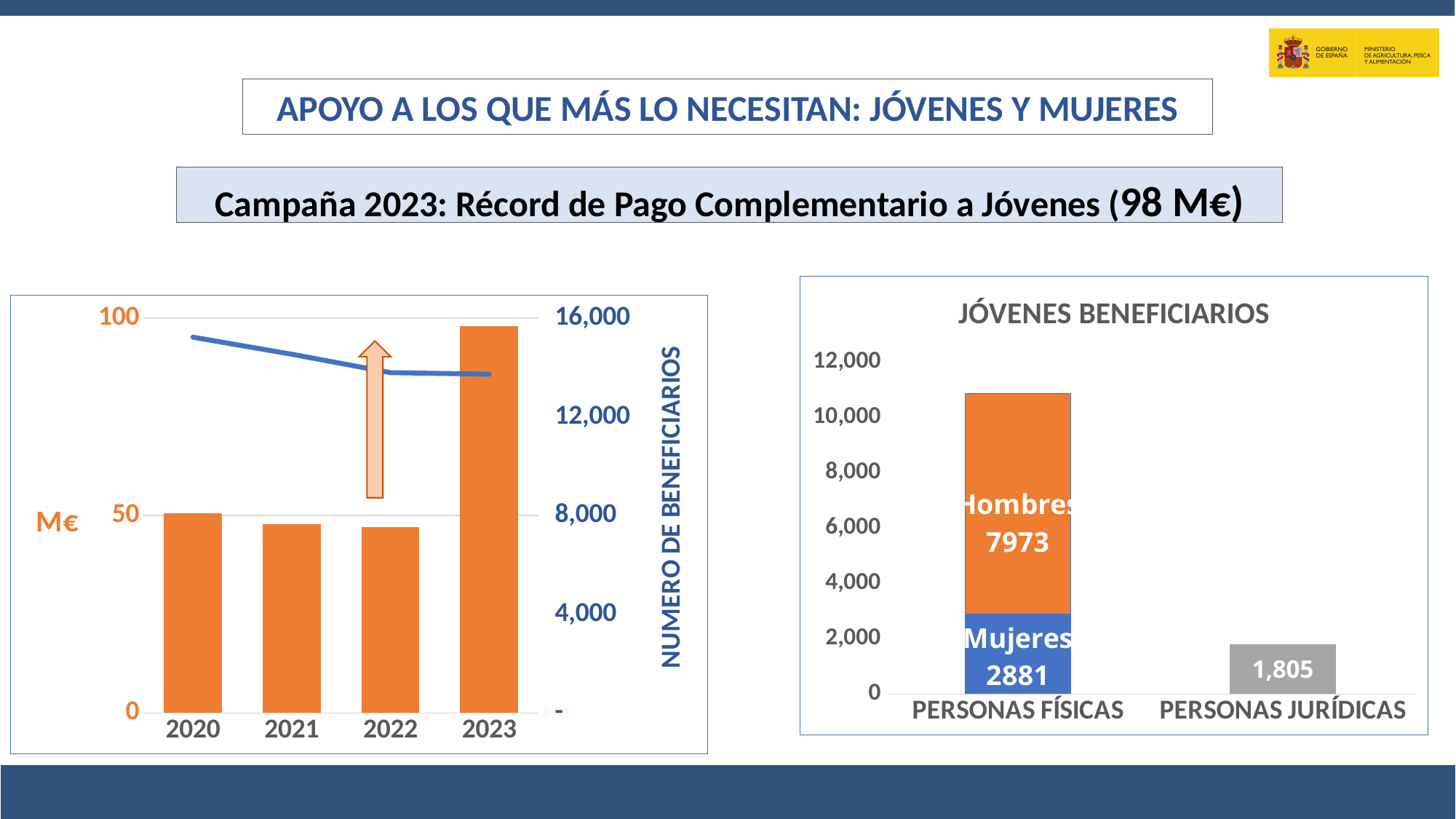
In the 'JÓVENES BENEFICIARIOS' chart, what is the value for PERSONAS JURÍDICAS? 1,805 What kind of chart is the 'JÓVENES BENEFICIARIOS' chart on the right? bar chart In the 'JÓVENES BENEFICIARIOS' chart, what is the value for Hombres? 7973 In the left chart, is the M€ bar for 2021 greater or less than 50? less In the 'JÓVENES BENEFICIARIOS' chart, what is the difference between Hombres and Mujeres? 5092 How many categories are shown on the x axis of the 'JÓVENES BENEFICIARIOS' chart? 2 In the 'JÓVENES BENEFICIARIOS' chart, what is the total of the stacked PERSONAS FÍSICAS bar (Hombres plus Mujeres)? 10854 In the left chart, does the NUMERO DE BENEFICIARIOS line rise or fall from 2020 to 2023? fall In the left chart, how many years are shown on the x axis? 4 In the 'JÓVENES BENEFICIARIOS' chart, which is larger, Hombres or Mujeres? Hombres In the left chart, which year has the highest M€ bar? 2023 In the 'JÓVENES BENEFICIARIOS' chart, what is the value for Mujeres? 2881